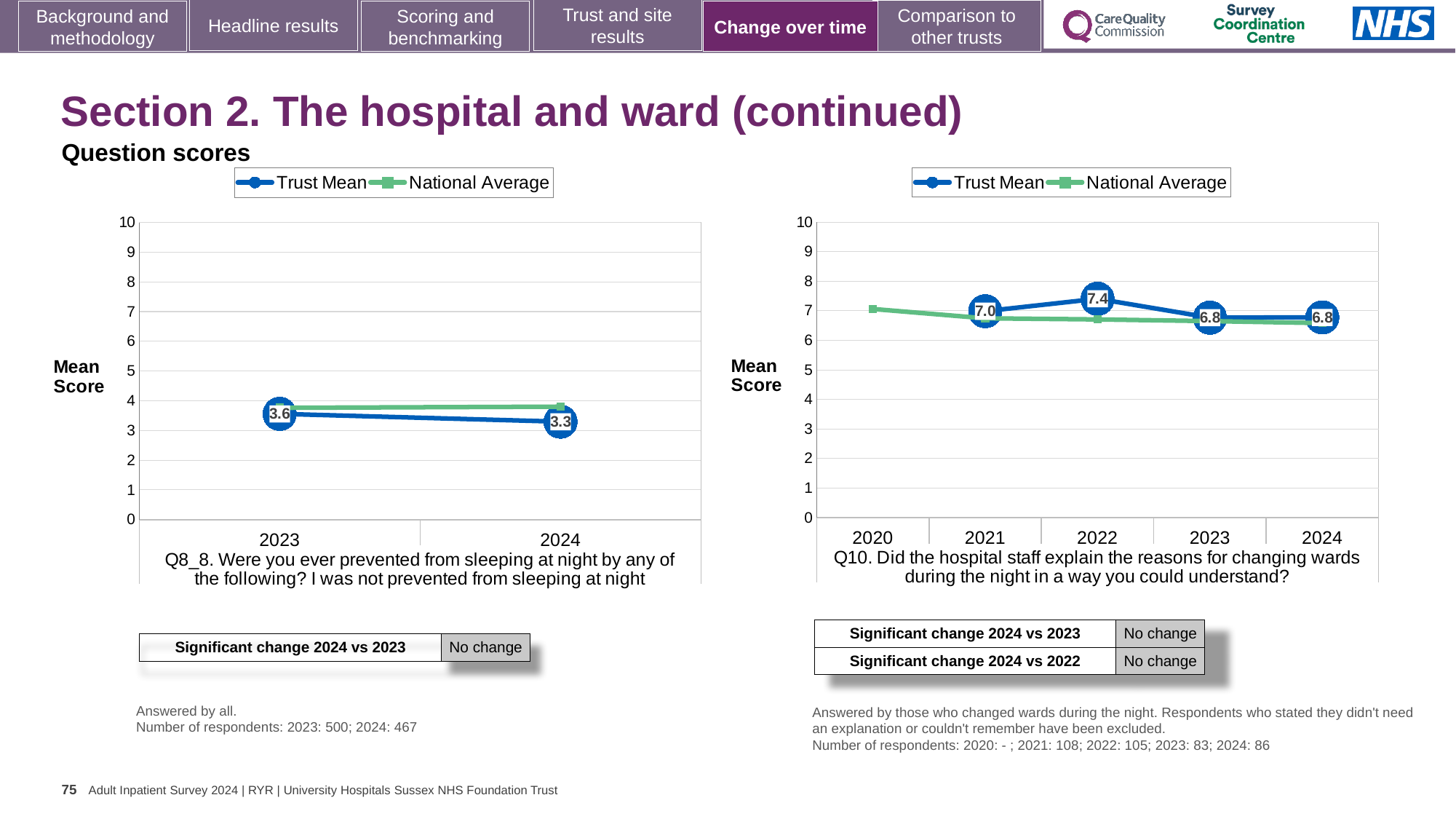
In the Q10 chart on the right, what is the Trust Mean score for 2021? 7.0 In the Q10 chart on the right, how many years are shown on the x axis? 5 In the Q10 chart on the right, what is the Trust Mean score for 2022? 7.4 How many series does the legend of the Q8_8 chart on the left list? 2 What kind of chart is the Q10 chart on the right? line chart In the Q8_8 chart on the left, what is the Trust Mean score for 2024? 3.3 In the Q10 chart on the right, which year has the highest Trust Mean score? 2022 In the Q8_8 chart on the left, does the Trust Mean rise or fall from 2023 to 2024? fall In the Q8_8 chart on the left, what is the Trust Mean score for 2023? 3.6 In the Q10 chart on the right, what is the difference between the Trust Mean in 2022 and in 2023? 0.6 In the Q10 chart on the right, is the National Average for 2020 greater or less than 6? greater In the Q8_8 chart on the left, by how much did the Trust Mean fall from 2023 to 2024? 0.3